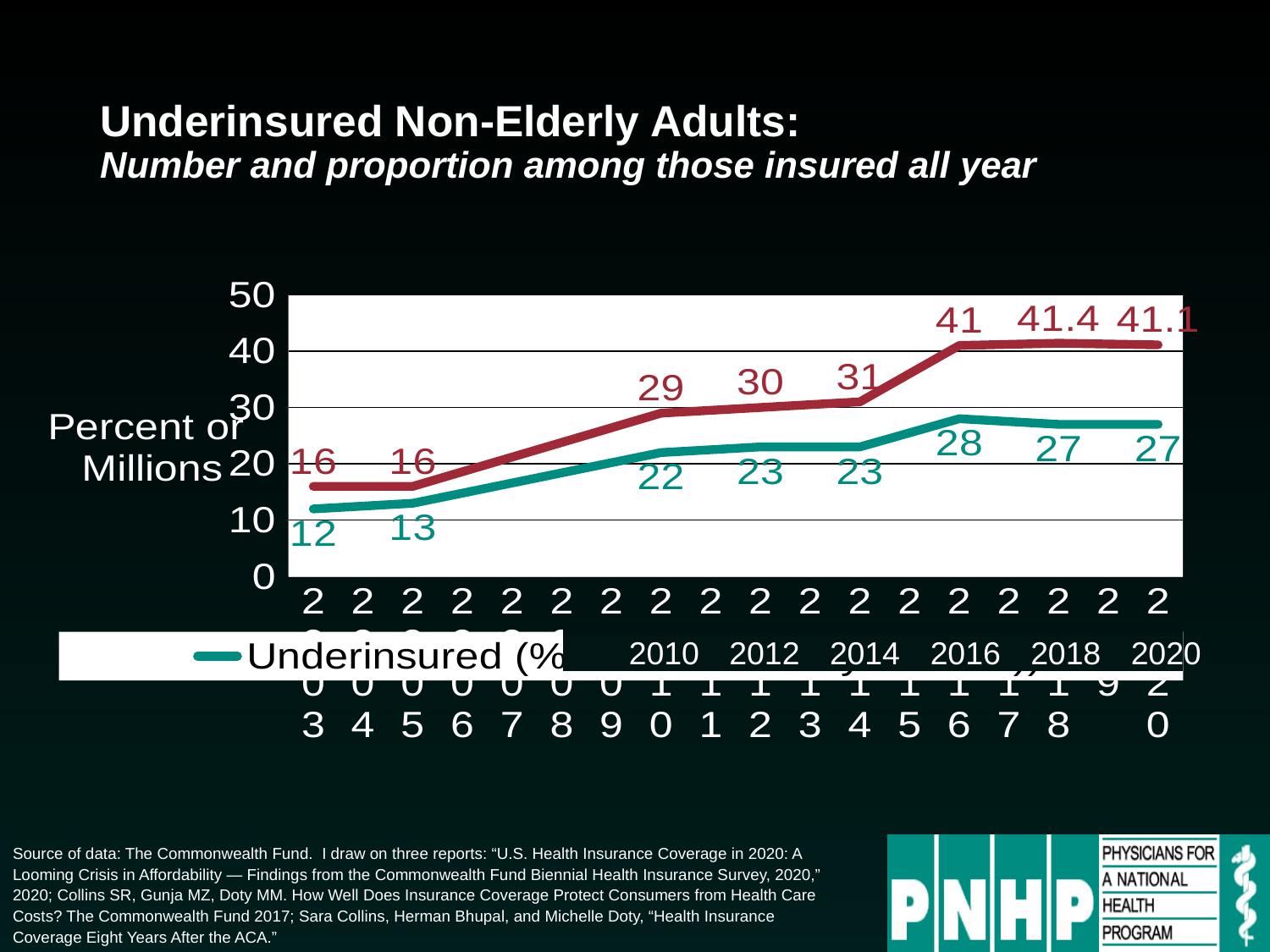
In which year does the red line reach its highest labeled value? 2018 What is the lowest labeled value on the Underinsured (%) line? 12 Is the Underinsured (%) value for 2020 greater or less than 30? less What kind of chart is shown on the slide? line chart What is the Underinsured (%) value in 2016? 28 Does the red line rise or fall between 2010 and 2016? rise In 2012, which is larger: the red line value or the Underinsured (%) value? the red line What is the difference between the red line's 2020 value and its 2016 value? 0.1 How many labeled data points are on the Underinsured (%) line? 8 What value does the red line show in 2018? 41.4 By how much did the Underinsured (%) value increase from 2010 to 2016? 6 What is the Underinsured (%) value in 2010? 22